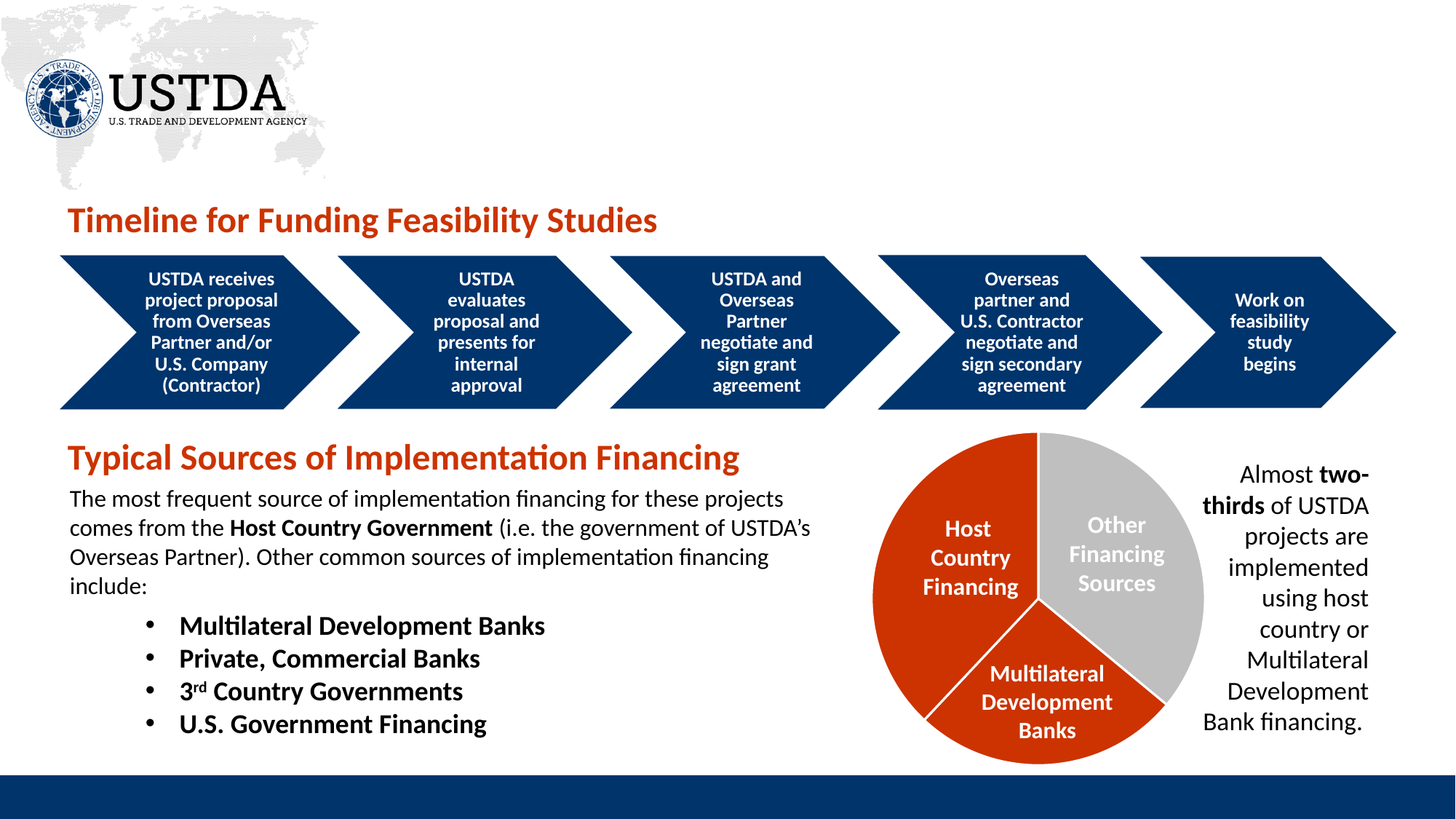
How many slices does the pie chart have? 3 Which slices of the pie chart are coloured orange-red? Host Country Financing and Multilateral Development Banks Which slice of the pie chart is the smallest? Multilateral Development Banks What colour is the Other Financing Sources slice in the pie chart? grey In the pie chart, which is larger: Other Financing Sources or Multilateral Development Banks? Other Financing Sources In the pie chart, which is larger: Host Country Financing or Multilateral Development Banks? Host Country Financing Which slice of the pie chart is the largest? Host Country Financing What kind of chart is shown on the slide? pie chart